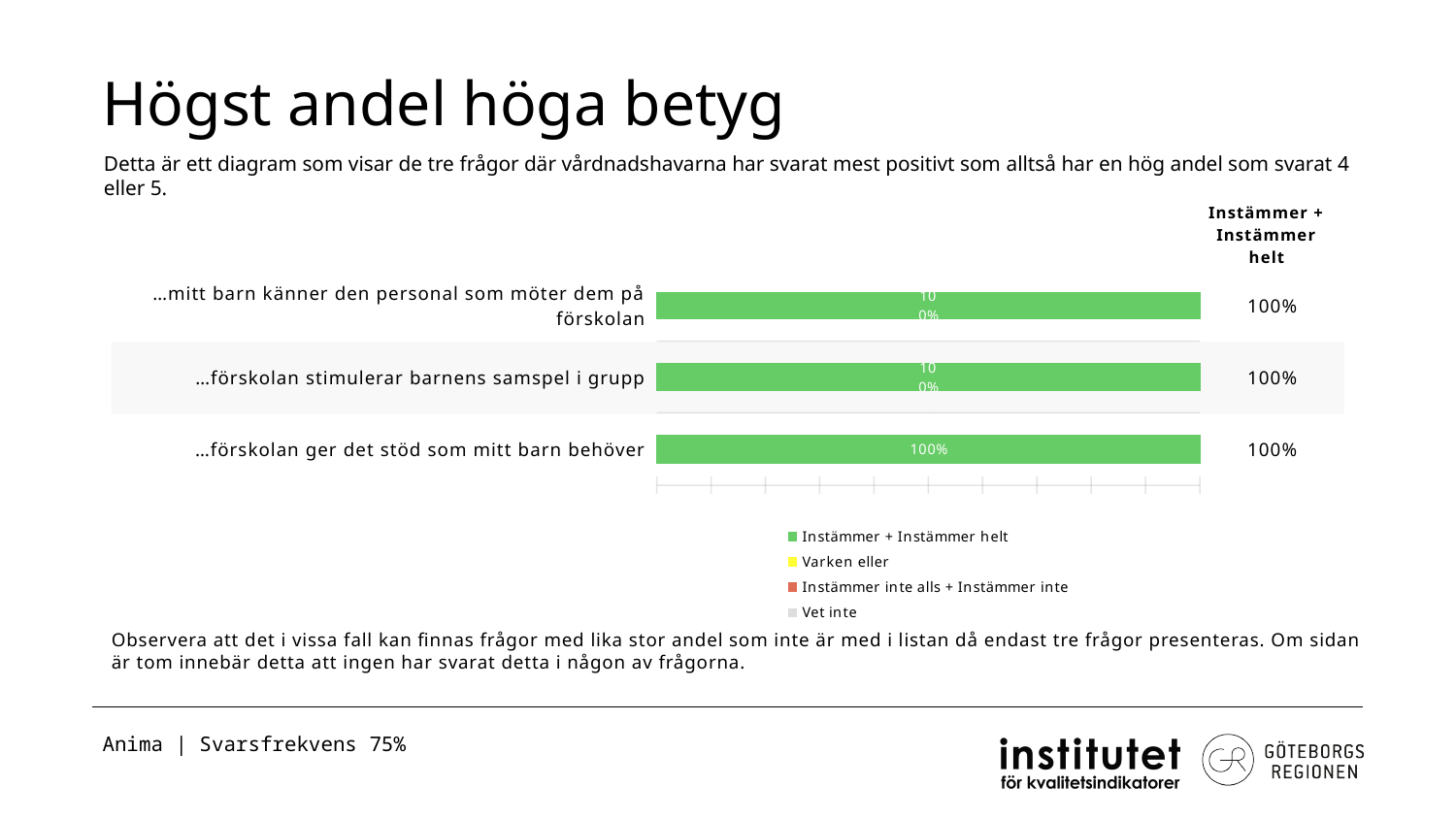
What is the value of "Instämmer + Instämmer helt" for "…förskolan stimulerar barnens samspel i grupp"? 100% What is the title of the slide containing the chart? Högst andel höga betyg Which colour represents "Instämmer + Instämmer helt" in the legend? Green How many series does the legend list? 4 What is the value of "Instämmer + Instämmer helt" for "…förskolan ger det stöd som mitt barn behöver"? 100% What is the value of "Instämmer + Instämmer helt" for "…mitt barn känner den personal som möter dem på förskolan"? 100% Is the value for "…förskolan ger det stöd som mitt barn behöver" greater or less than 50%? greater How many questions (categories) are shown in the chart? 3 What kind of chart is shown on the slide? Stacked bar chart What is the difference between the "Instämmer + Instämmer helt" values for "…förskolan stimulerar barnens samspel i grupp" and "…förskolan ger det stöd som mitt barn behöver"? 0%